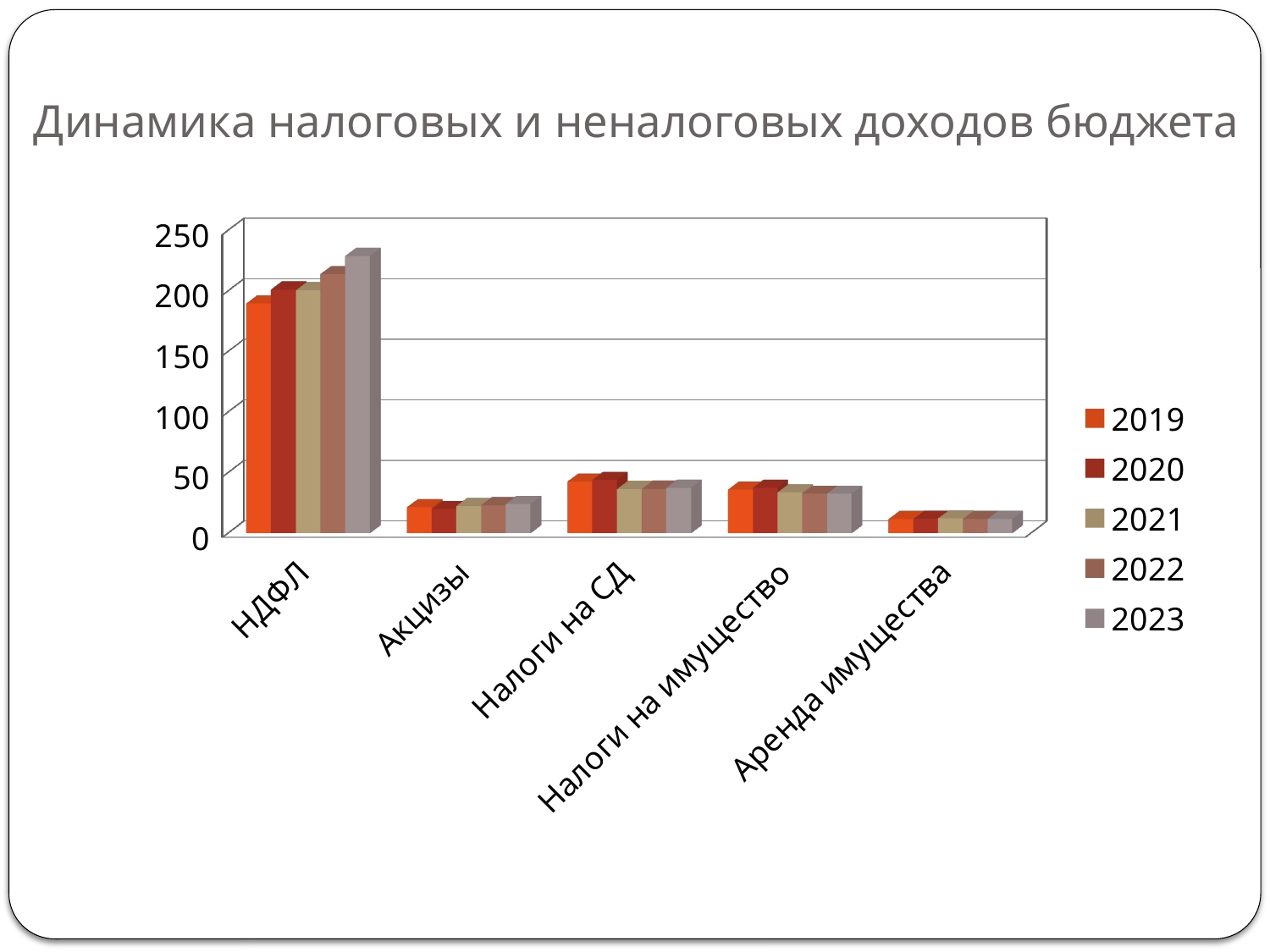
How many series does the legend list? 5 Is the value for НДФЛ in 2019 greater or less than 150? greater What is the title of the slide? Динамика налоговых и неналоговых доходов бюджета Is the value for НДФЛ in 2023 greater or less than 200? greater Do the values for НДФЛ rise or fall from 2019 to 2023? rise How many categories are shown on the x axis of the chart? 5 What kind of chart is shown on the slide? bar chart Is the value for Аренда имущества in 2023 greater or less than 50? less Which category has the highest values in the chart? НДФЛ Which category has the lowest values in the chart? Аренда имущества Which is larger: the value for НДФЛ in 2023 or the value for Налоги на СД in 2023? НДФЛ in 2023